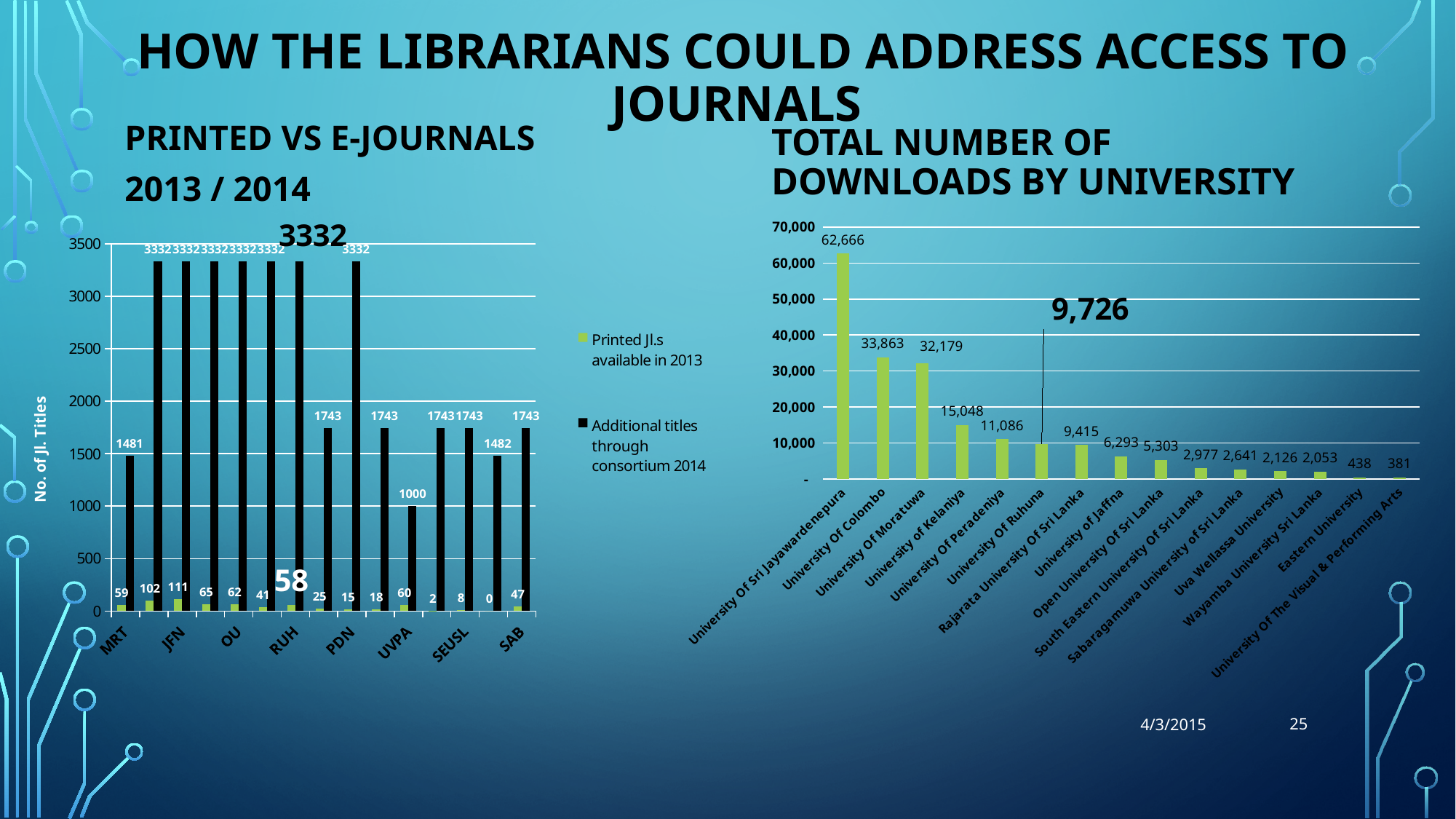
In the 'Total Number of Downloads by University' chart, what is the difference between the downloads of University Of Colombo and University Of Moratuwa? 1,684 In the 'Printed vs E-Journals 2013 / 2014' chart, what is the value of 'Additional titles through consortium 2014' for MRT? 1481 In the 'Total Number of Downloads by University' chart, do the values rise or fall from left to right? fall What kind of chart is the 'Total Number of Downloads by University' chart? bar chart In the 'Total Number of Downloads by University' chart, which has more downloads: University of Kelaniya or University Of Peradeniya? University of Kelaniya In the 'Total Number of Downloads by University' chart, how many downloads does Eastern University have? 438 How many series does the legend of the 'Printed vs E-Journals 2013 / 2014' chart list? 2 How many universities are shown in the 'Total Number of Downloads by University' chart? 15 In the 'Total Number of Downloads by University' chart, which university has the lowest number of downloads? University Of The Visual & Performing Arts In the 'Total Number of Downloads by University' chart, which university has the highest number of downloads? University Of Sri Jayawardenepura In the 'Total Number of Downloads by University' chart, what is the value for University Of Ruhuna? 9,726 In the 'Total Number of Downloads by University' chart, how many downloads does University Of Colombo have? 33,863